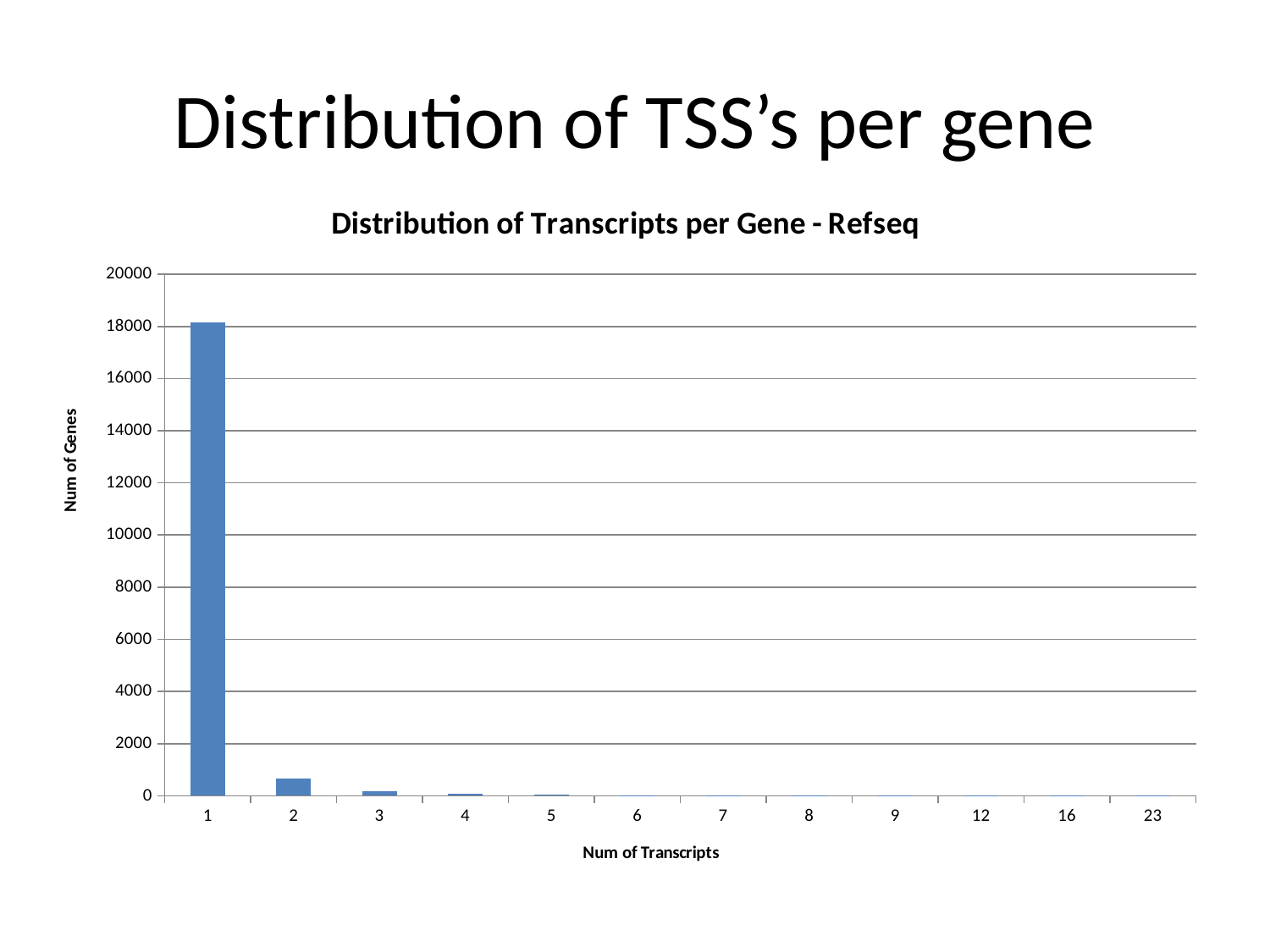
Which has more genes: 1 transcript or 2 transcripts? 1 transcript What is the title of the chart? Distribution of Transcripts per Gene - Refseq Is the value for 3 transcripts greater or less than 2000? less How many categories are shown on the x axis of the chart? 12 Which number of transcripts has the highest number of genes? 1 Which has more genes: 2 transcripts or 3 transcripts? 2 transcripts Do the values rise or fall as the number of transcripts increases along the x axis? fall What kind of chart is shown on the slide? bar chart Is the value for 2 transcripts greater or less than 2000? less Is the value for 1 transcript greater or less than 16000? greater What is the label of the y axis? Num of Genes